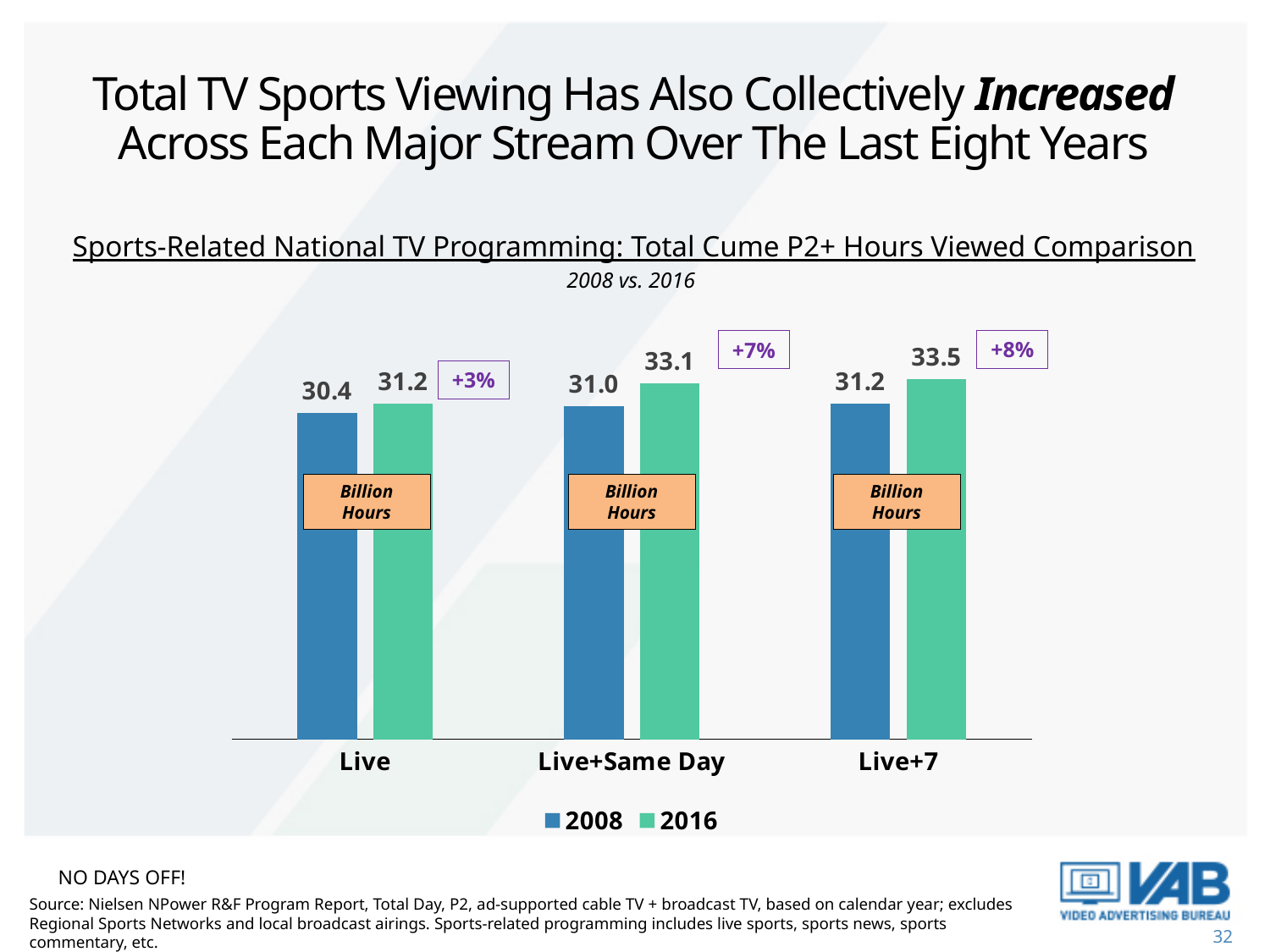
Which category has the highest 2016 value? Live+7 What is the 2008 value for Live? 30.4 What is the 2016 value for Live+Same Day? 33.1 How many categories are shown on the x axis? 3 What is the difference between the 2016 and 2008 values for Live+Same Day? 2.1 What is the 2016 value for Live+7? 33.5 Which category has the lowest 2008 value? Live Which is larger, the 2016 value for Live or the 2008 value for Live+Same Day? 2016 value for Live What kind of chart is shown? Bar chart What is the difference between the 2016 and 2008 values for Live+7? 2.3 What percentage change is shown for Live+Same Day? +7% How many series does the legend list? 2